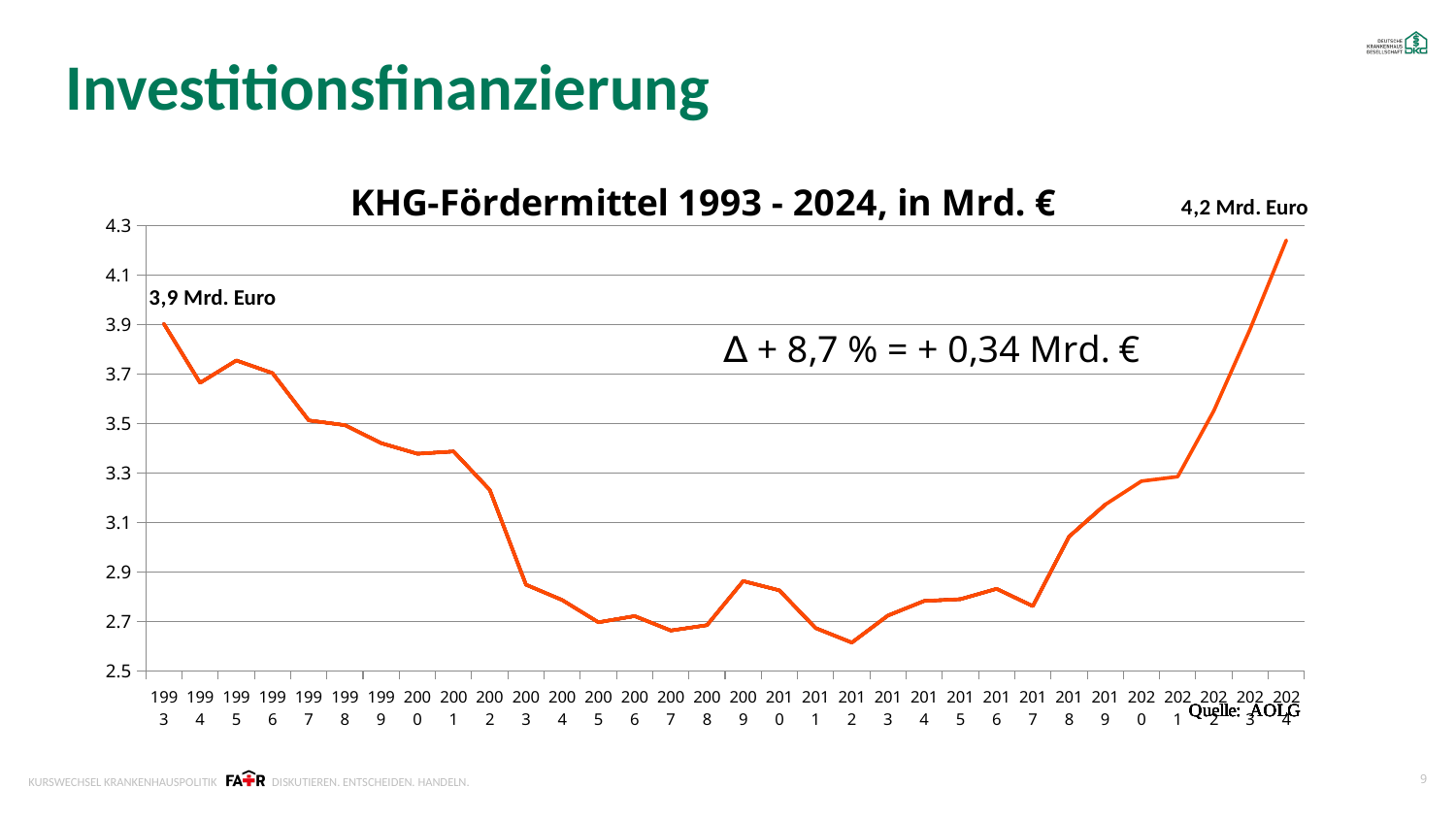
Is the value for 2003 greater or less than 2.9? less Which year has the lowest value in the chart? 2012 Which is larger, the value for 1993 or the value for 2024? 2024 What value is labelled for the year 1993? 3,9 Mrd. Euro What is the title of the chart? KHG-Fördermittel 1993 - 2024, in Mrd. € How many years are plotted on the x axis? 32 What type of chart is shown on the slide? line chart Do the values rise or fall from 2017 to 2024? rise Is the value for 2002 greater or less than 3.3? less What value is labelled for the year 2024? 4,2 Mrd. Euro Which year has the highest value in the chart? 2024 Is the value for 2020 greater or less than 3.1? greater